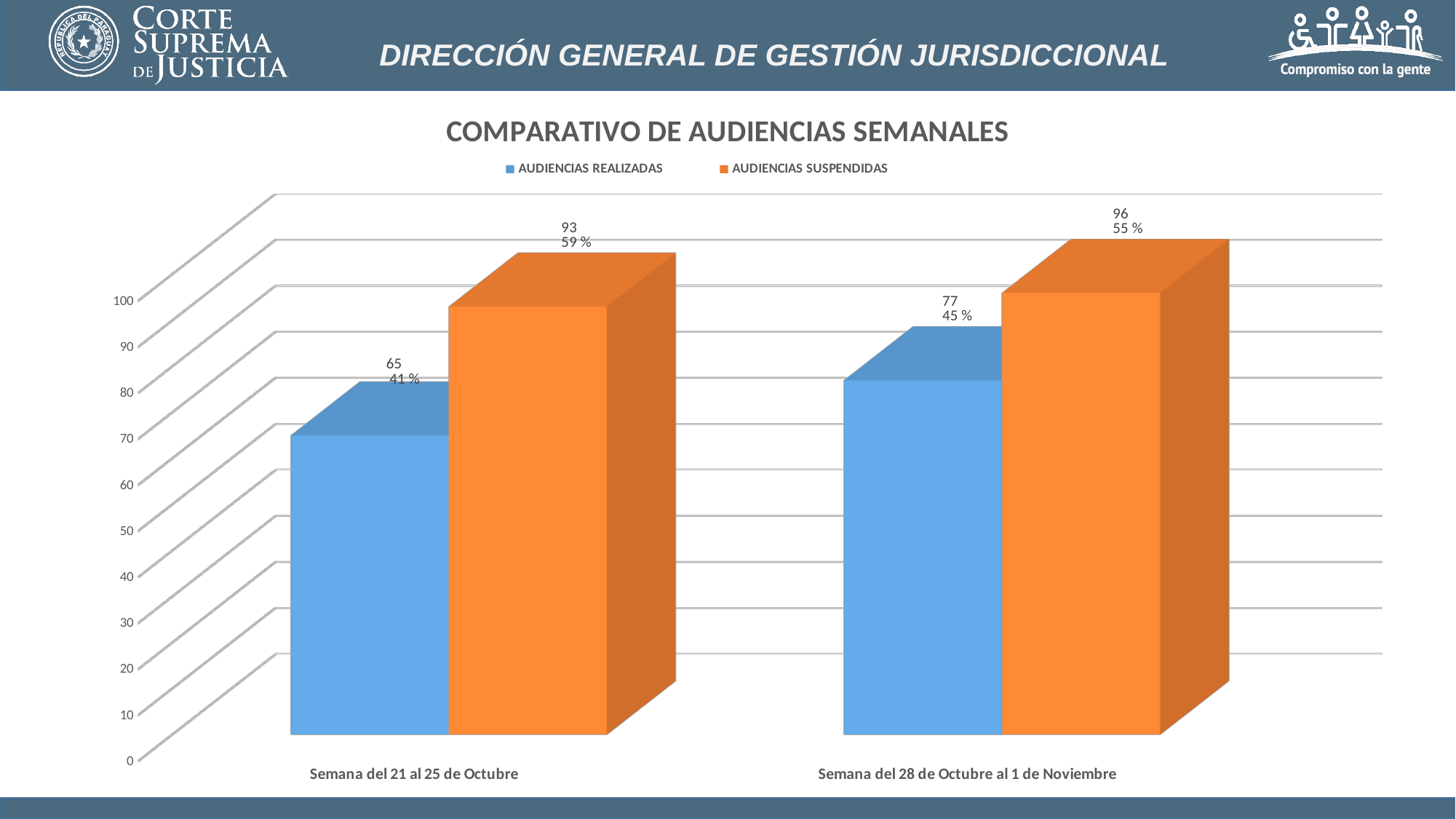
Which week has the lower value for AUDIENCIAS SUSPENDIDAS? Semana del 21 al 25 de Octubre What is the title of the chart? COMPARATIVO DE AUDIENCIAS SEMANALES What is the value of AUDIENCIAS REALIZADAS for Semana del 21 al 25 de Octubre? 65 How many series does the legend list? 2 What is the difference between AUDIENCIAS SUSPENDIDAS and AUDIENCIAS REALIZADAS for Semana del 21 al 25 de Octubre? 28 How many weeks (categories) are shown on the x axis? 2 What percentage is shown for AUDIENCIAS REALIZADAS in Semana del 28 de Octubre al 1 de Noviembre? 45 % What is the value of AUDIENCIAS SUSPENDIDAS for Semana del 28 de Octubre al 1 de Noviembre? 96 What kind of chart is shown on the slide? Bar chart What percentage is shown for AUDIENCIAS SUSPENDIDAS in Semana del 21 al 25 de Octubre? 59 % Which is larger for Semana del 28 de Octubre al 1 de Noviembre: AUDIENCIAS REALIZADAS or AUDIENCIAS SUSPENDIDAS? AUDIENCIAS SUSPENDIDAS Which week has the higher value for AUDIENCIAS REALIZADAS? Semana del 28 de Octubre al 1 de Noviembre